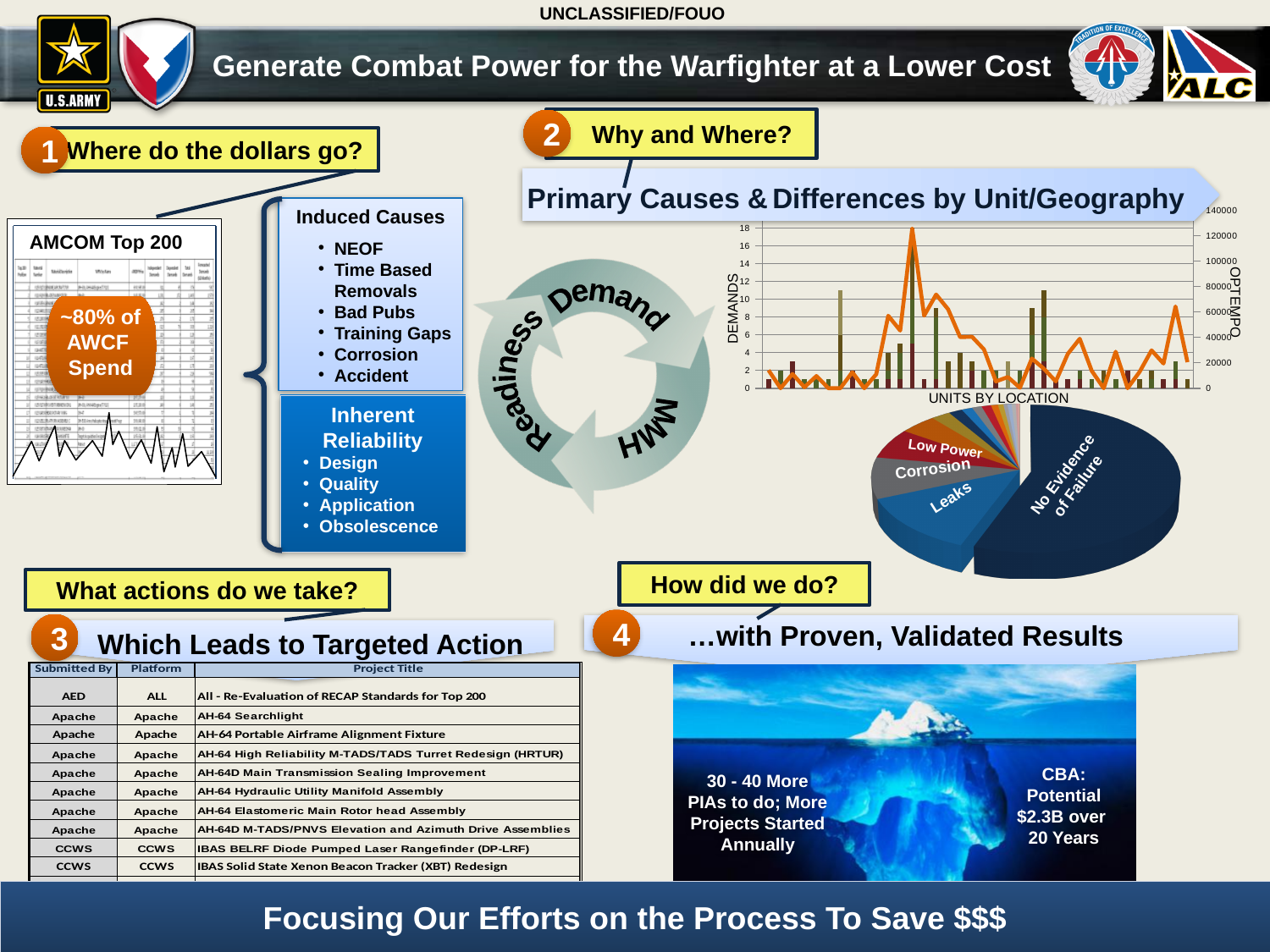
In the 'UNITS BY LOCATION' chart, what is the highest tick value shown on the left DEMANDS axis? 18 What kind of chart is shown below the 'UNITS BY LOCATION' chart, with the 'No Evidence of Failure' slice? Pie chart In the 'UNITS BY LOCATION' chart, what is the title of the right vertical axis? OPTEMPO In the pie chart on the right side of the slide, which slice is larger: 'No Evidence of Failure' or 'Leaks'? No Evidence of Failure In the pie chart on the right side of the slide, is the 'No Evidence of Failure' slice greater or less than half of the pie? greater In the pie chart on the right side of the slide, which labelled slice is the largest? No Evidence of Failure In the 'UNITS BY LOCATION' chart, is the tallest DEMANDS bar greater or less than 8? greater In the 'UNITS BY LOCATION' chart, what is the title of the left vertical axis? DEMANDS What kind of chart is the 'UNITS BY LOCATION' chart in the upper right of the slide? A combined bar and line chart In the 'UNITS BY LOCATION' chart, is the peak of the orange OPTEMPO line greater or less than 100000? greater In the 'UNITS BY LOCATION' chart, what is the highest tick value shown on the right OPTEMPO axis? 140000